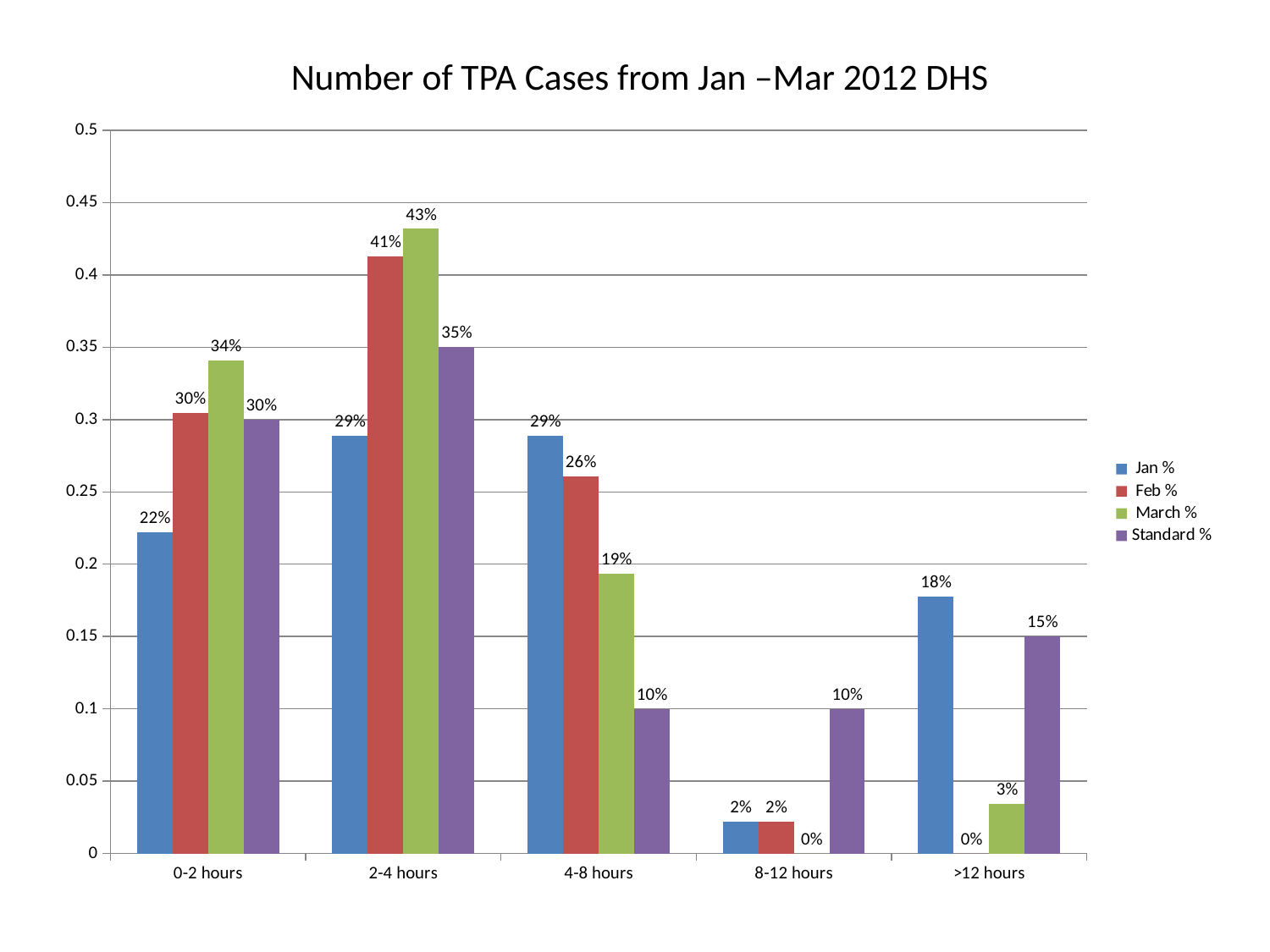
What is the title of the chart? Number of TPA Cases from Jan –Mar 2012 DHS What is the difference between the March % and Jan % values for the 0-2 hours category? 12% Which category has the lowest Feb % value? >12 hours What kind of chart is shown on the slide? Bar chart What is the March % value for the 2-4 hours category? 43% What is the Standard % value for the 4-8 hours category? 10% How many series does the legend list? 4 What is the Feb % value for the 8-12 hours category? 2% Which category has the highest March % value? 2-4 hours What is the Jan % value for the >12 hours category? 18% Which is larger for the 4-8 hours category, the Jan % value or the Feb % value? Jan % How many categories are shown on the x axis? 5